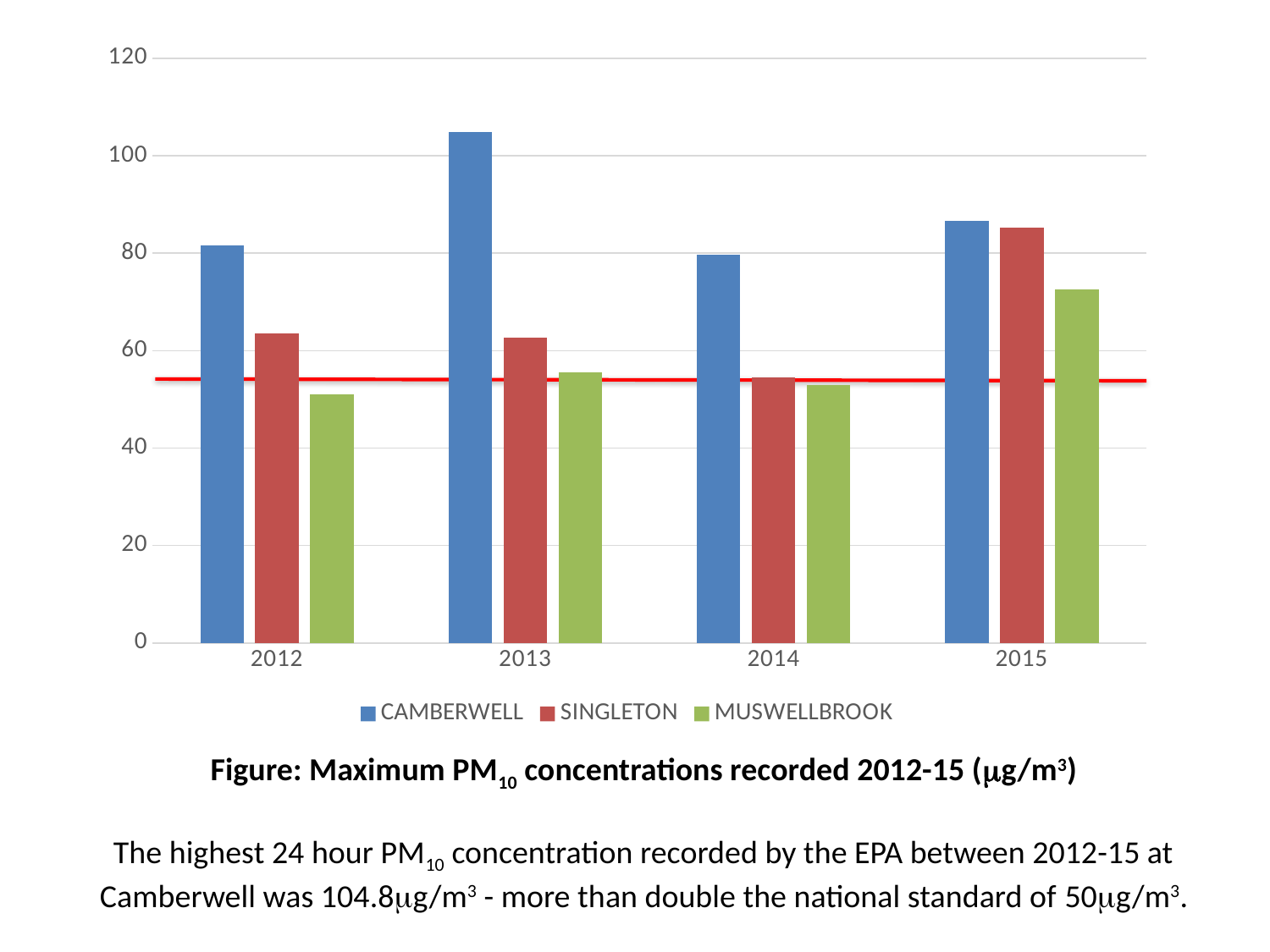
Is the value for Muswellbrook in 2012 greater or less than 60? less Is the value for Singleton in 2015 greater or less than 80? greater How many series does the legend list? 3 Which location has the highest bar in 2012? Camberwell Is the value for Camberwell in 2013 greater or less than 100? greater Which series is shown in green in the legend? Muswellbrook What kind of chart is shown on the slide? bar chart How many years are shown on the x axis? 4 In 2012, which is larger: the Singleton value or the Muswellbrook value? Singleton In which year is the Camberwell bar the highest? 2013 Which location has the lowest bar in 2013? Muswellbrook